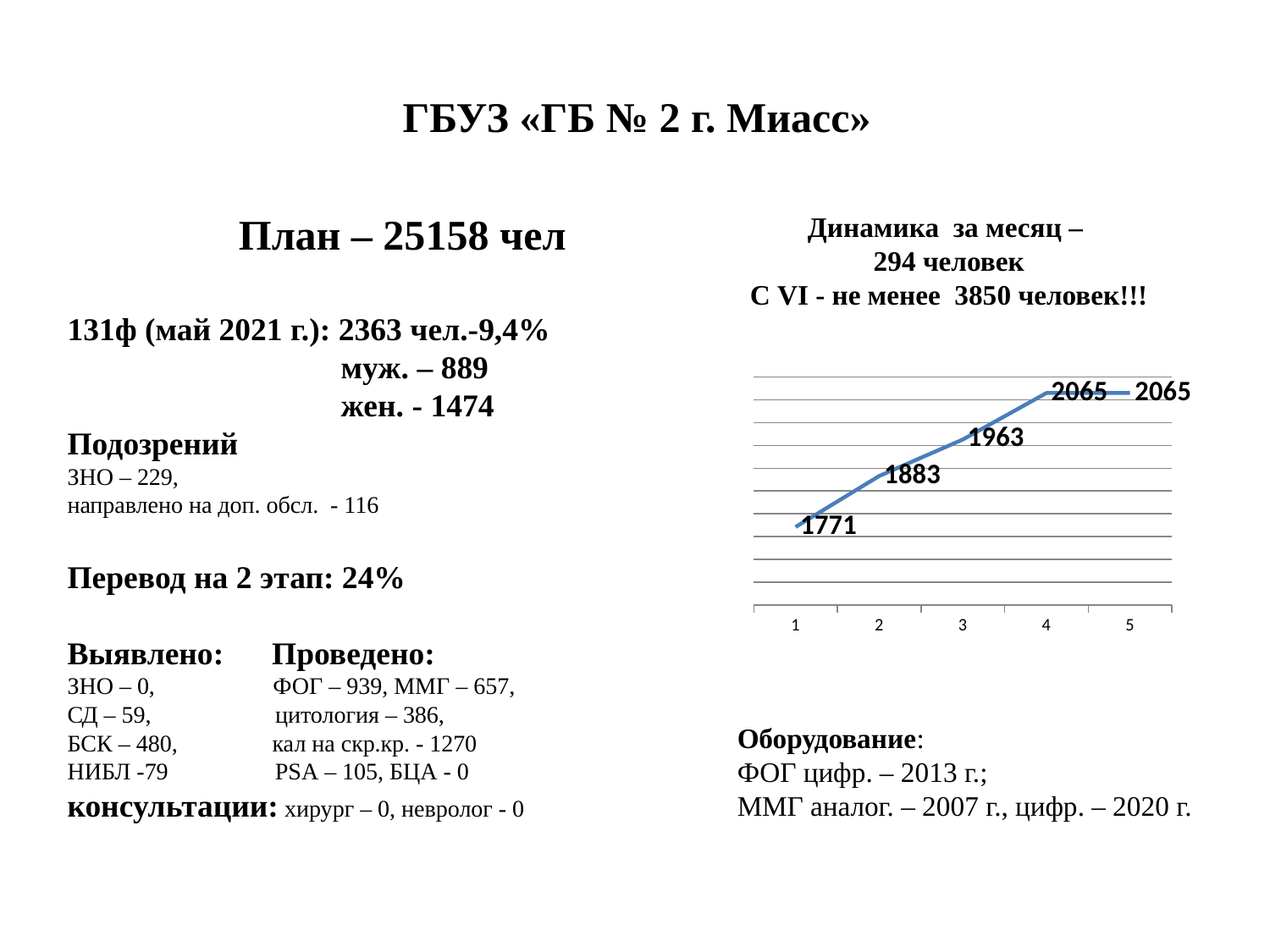
Do the values on the line chart generally rise or fall from point 1 to point 5? rise What is the value at point 1 on the line chart? 1771 What is the value at point 4 on the line chart? 2065 What is the difference between the values at point 4 and point 3 on the line chart? 102 What is the value at point 3 on the line chart? 1963 What is the value at point 5 on the line chart? 2065 What type of chart is shown on the slide? line chart What is the value at point 2 on the line chart? 1883 How many data points are plotted on the line chart? 5 What is the difference between the values at point 2 and point 1 on the line chart? 112 Which is larger on the line chart, the value at point 3 or the value at point 2? point 3 Which point on the line chart has the lowest value? 1